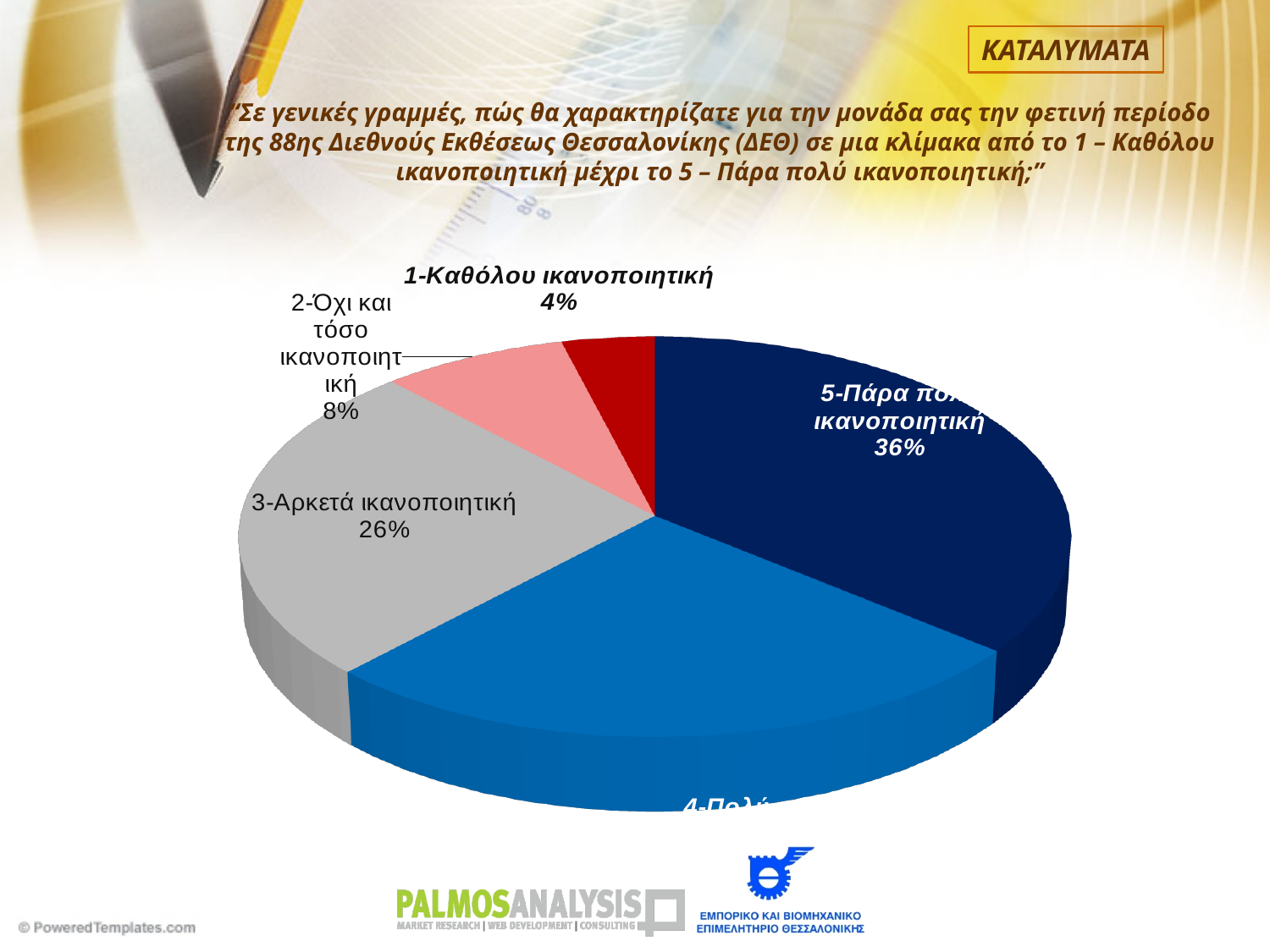
What is the combined share of "1-Καθόλου ικανοποιητική" and "2-Όχι και τόσο ικανοποιητική"? 12% What is the difference in percentage points between "5-Πάρα πολύ ικανοποιητική" and "3-Αρκετά ικανοποιητική"? 10 Which category has the smallest share of the pie? 1-Καθόλου ικανοποιητική What is the difference in percentage points between "2-Όχι και τόσο ικανοποιητική" and "1-Καθόλου ικανοποιητική"? 4 Which is larger: the share for "3-Αρκετά ικανοποιητική" or the share for "2-Όχι και τόσο ικανοποιητική"? 3-Αρκετά ικανοποιητική What percentage of respondents answered "2-Όχι και τόσο ικανοποιητική"? 8% What kind of chart is shown on the slide? pie chart What percentage of respondents answered "3-Αρκετά ικανοποιητική"? 26% What percentage of respondents answered "1-Καθόλου ικανοποιητική"? 4% What percentage of respondents answered "5-Πάρα πολύ ικανοποιητική"? 36% What colour is the slice for "1-Καθόλου ικανοποιητική"? dark red How many slices does the pie chart have? 5